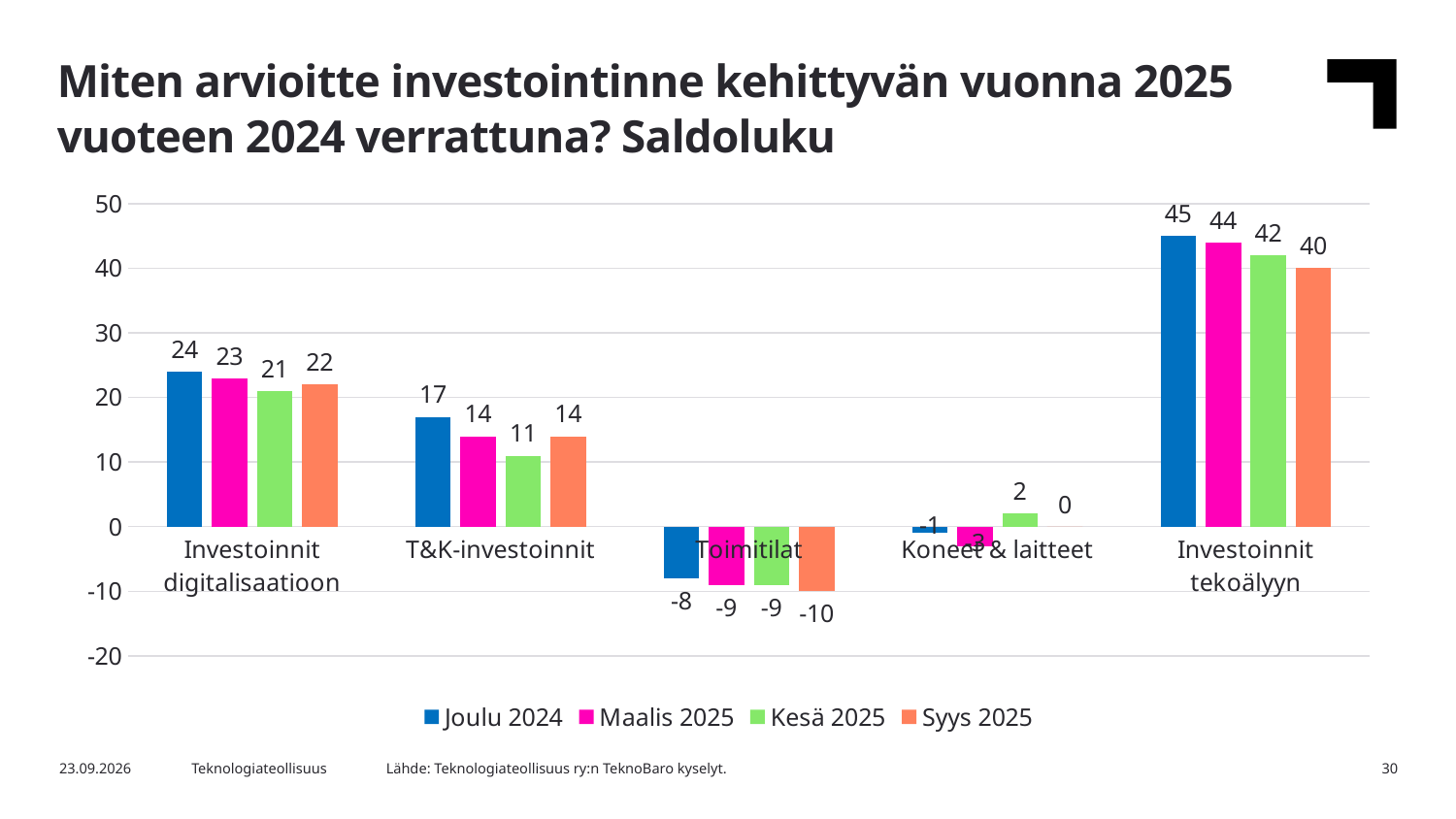
What is the difference between the Joulu 2024 and Syys 2025 values for Investoinnit tekoälyyn? 5 Which is larger for T&K-investoinnit: the Joulu 2024 value or the Maalis 2025 value? Joulu 2024 Which category has the highest value in the Syys 2025 series? Investoinnit tekoälyyn What is the value for Investoinnit tekoälyyn in the Joulu 2024 series? 45 What is the value for Investoinnit digitalisaatioon in the Maalis 2025 series? 23 What is the value for T&K-investoinnit in the Kesä 2025 series? 11 How many categories are shown on the x axis? 5 How many series does the legend list? 4 Which category has the lowest value in the Joulu 2024 series? Toimitilat Which series is shown in pink in the legend? Maalis 2025 What kind of chart is shown on the slide? Bar chart What is the value for Toimitilat in the Syys 2025 series? -10